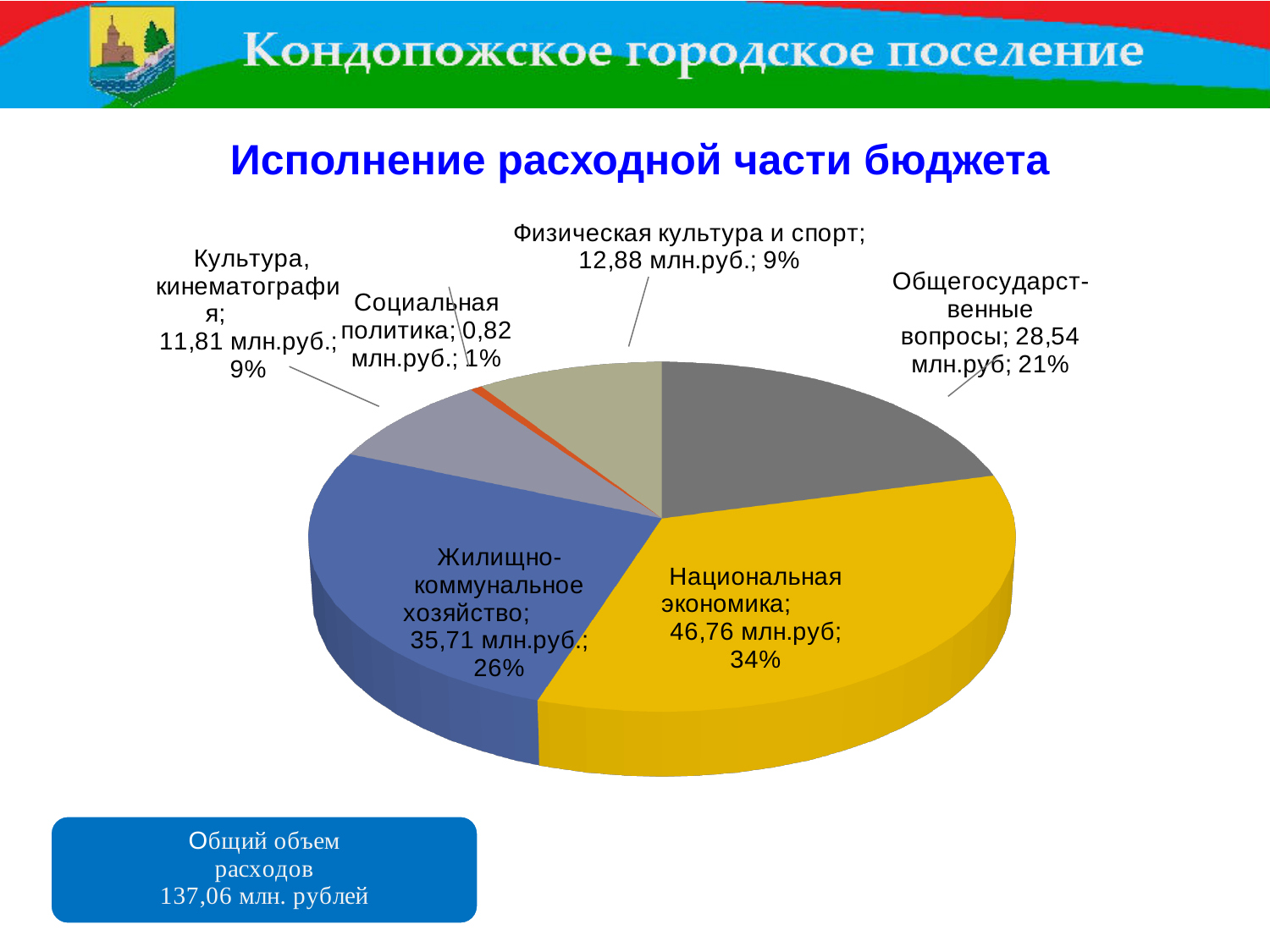
What is the title of the chart? Исполнение расходной части бюджета What share of the pie does Физическая культура и спорт represent? 9% What is the value for Жилищно-коммунальное хозяйство? 35,71 млн.руб. What is the value for Общегосударственные вопросы? 28,54 млн.руб Which category has the largest slice? Национальная экономика What is the value for Национальная экономика? 46,76 млн.руб Which category has the smallest slice? Социальная политика What kind of chart is shown on the slide? Pie chart Which is larger, the value for Общегосударственные вопросы or the value for Культура, кинематография? Общегосударственные вопросы How many slices does the pie chart have? 6 What is the difference between the values for Национальная экономика and Жилищно-коммунальное хозяйство? 11,05 млн.руб. What share of the pie does Социальная политика represent? 1%